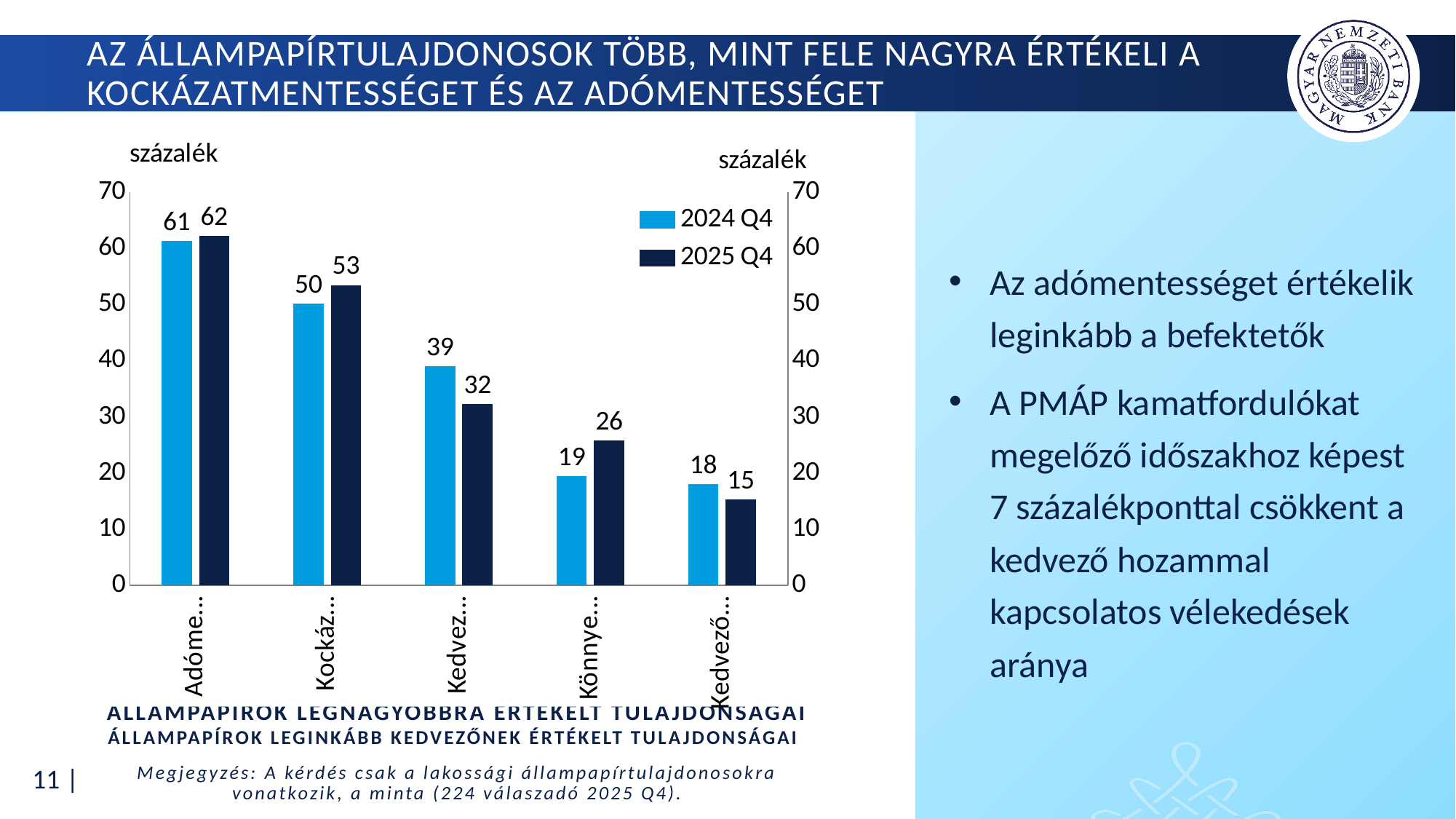
What is the 2025 Q4 value for the first category from the left (Adóme...)? 62 How many series does the chart's legend list? 2 Do the 2024 Q4 values rise or fall from left to right across the categories? fall How many categories are plotted along the x axis of the chart? 5 What kind of chart is shown on the slide? bar chart What is the 2024 Q4 value for the third category from the left (Kedvez...)? 39 Which category has the lowest 2025 Q4 value? the fifth category (Kedvező...) Which category has the highest 2025 Q4 value? the first category (Adóme...) What is the 2025 Q4 value for the fourth category from the left (Könnye...)? 26 For the fourth category from the left (Könnye...), which series has the larger value, 2024 Q4 or 2025 Q4? 2025 Q4 What unit label is shown above the y axes of the chart? százalék For the third category from the left (Kedvez...), what is the difference between the 2024 Q4 and 2025 Q4 values? 7